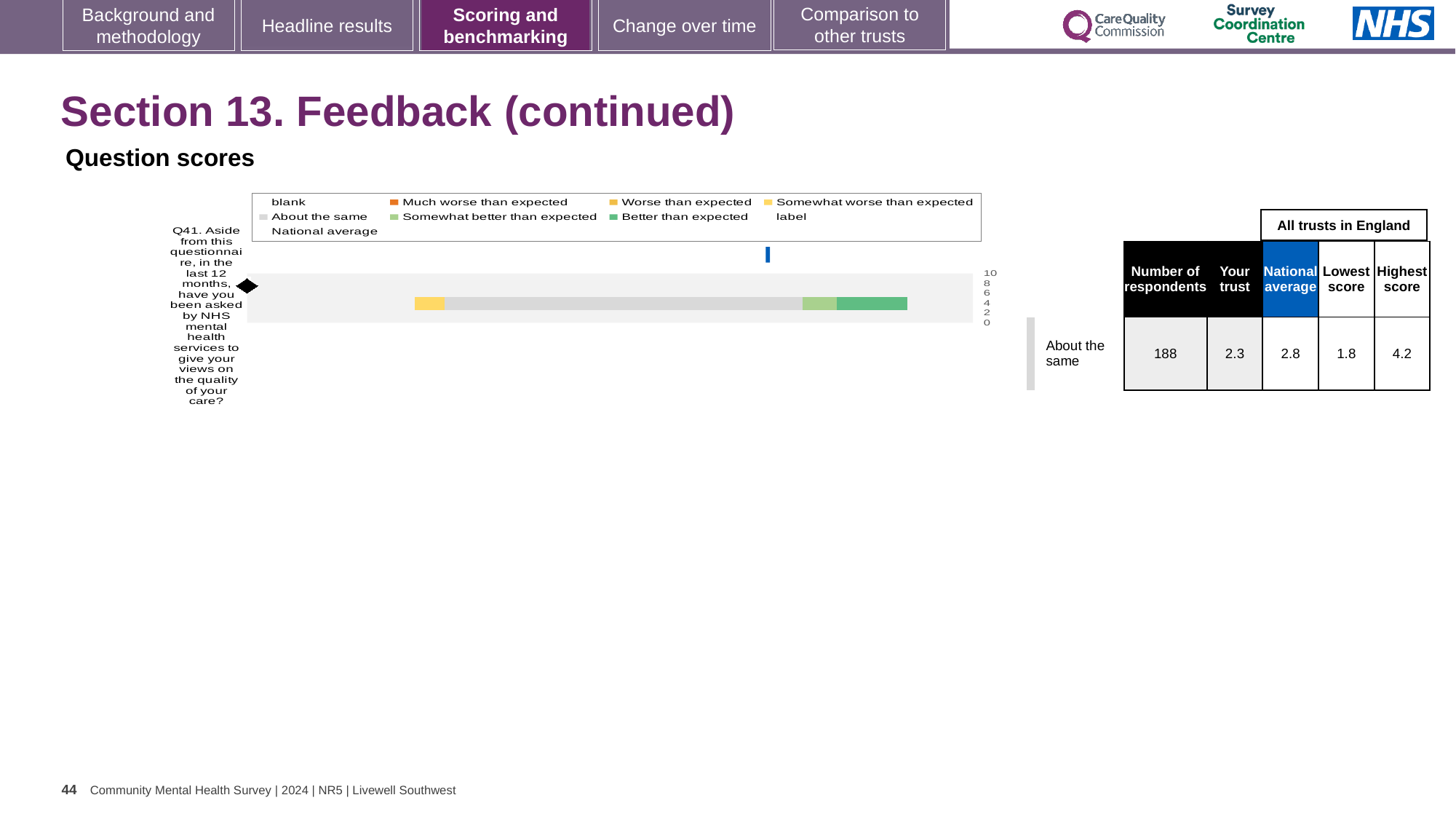
In the table, what is the national average score for Q41? 2.8 What colour is the 'Better than expected' segment in the bar chart? green How many questions (categories) are plotted in the bar chart? 1 In the table, what is the number of respondents for Q41? 188 Which legend category occupies the widest segment of the Q41 bar? About the same What is the difference between the highest score and the lowest score for Q41 in the table? 2.4 In the table, what is the highest score among all trusts in England for Q41? 4.2 In the table, what is the 'Your trust' score for Q41? 2.3 In the table, what is the lowest score among all trusts in England for Q41? 1.8 Which question is plotted in the bar chart? Q41. Aside from this questionnaire, in the last 12 months, have you been asked by NHS mental health services to give your views on the quality of your care? What kind of chart is shown on the slide? bar chart Which is larger for Q41: the 'Your trust' score or the national average? National average